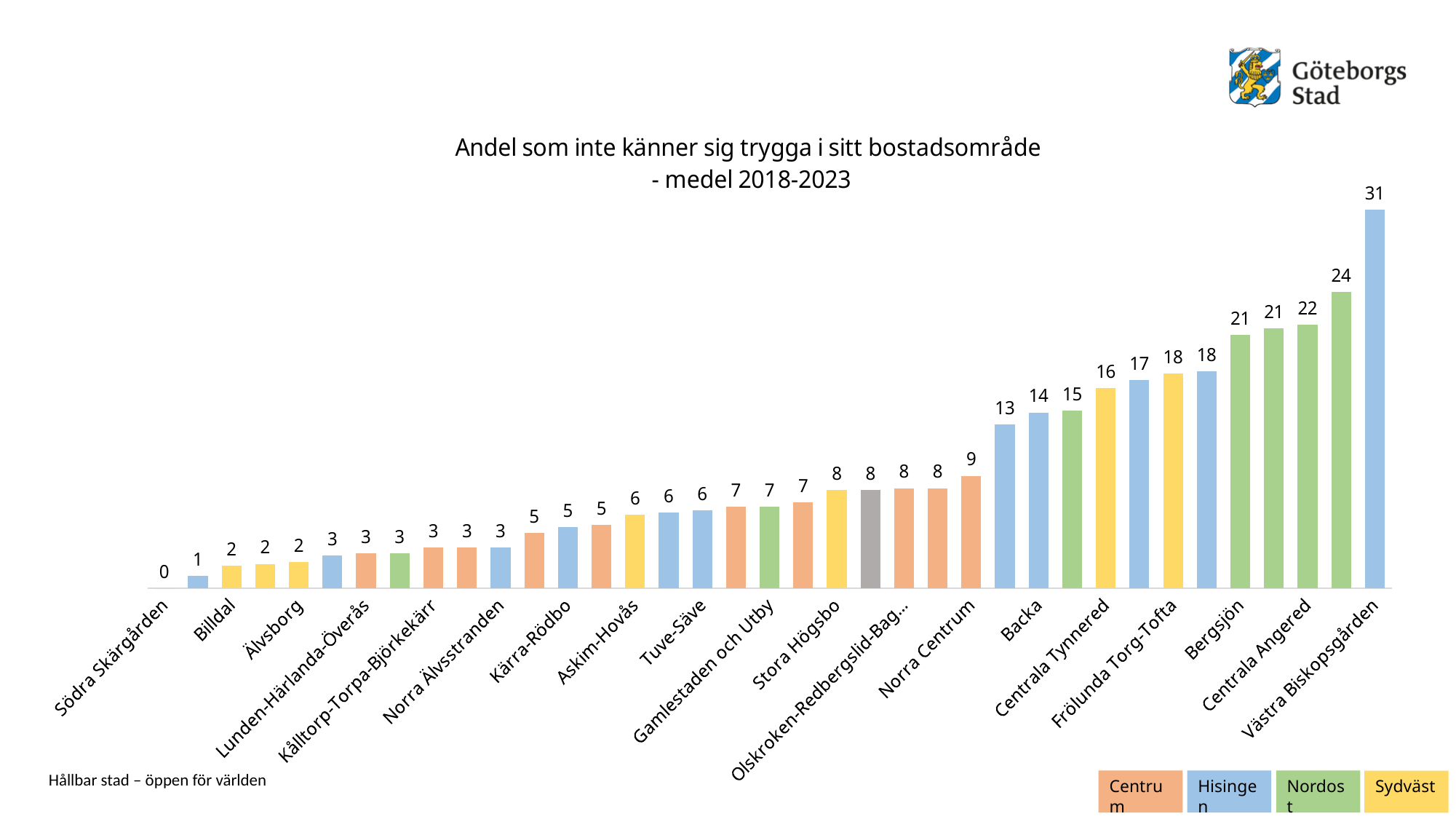
What is the value for Backa? 14 Do the values rise or fall from left to right along the x axis? Rise What is the value for Bergsjön? 21 What is the value for Västra Biskopsgården? 31 How many series does the legend list? 4 Which area has the lowest value? Södra Skärgården Which area has the highest value? Västra Biskopsgården Which is larger, the value for Backa or the value for Norra Centrum? Backa Which legend entry is shown in green? Nordost What is the difference between the values for Västra Biskopsgården and Centrala Angered? 9 What kind of chart is shown? Bar chart What is the value for Norra Centrum? 9